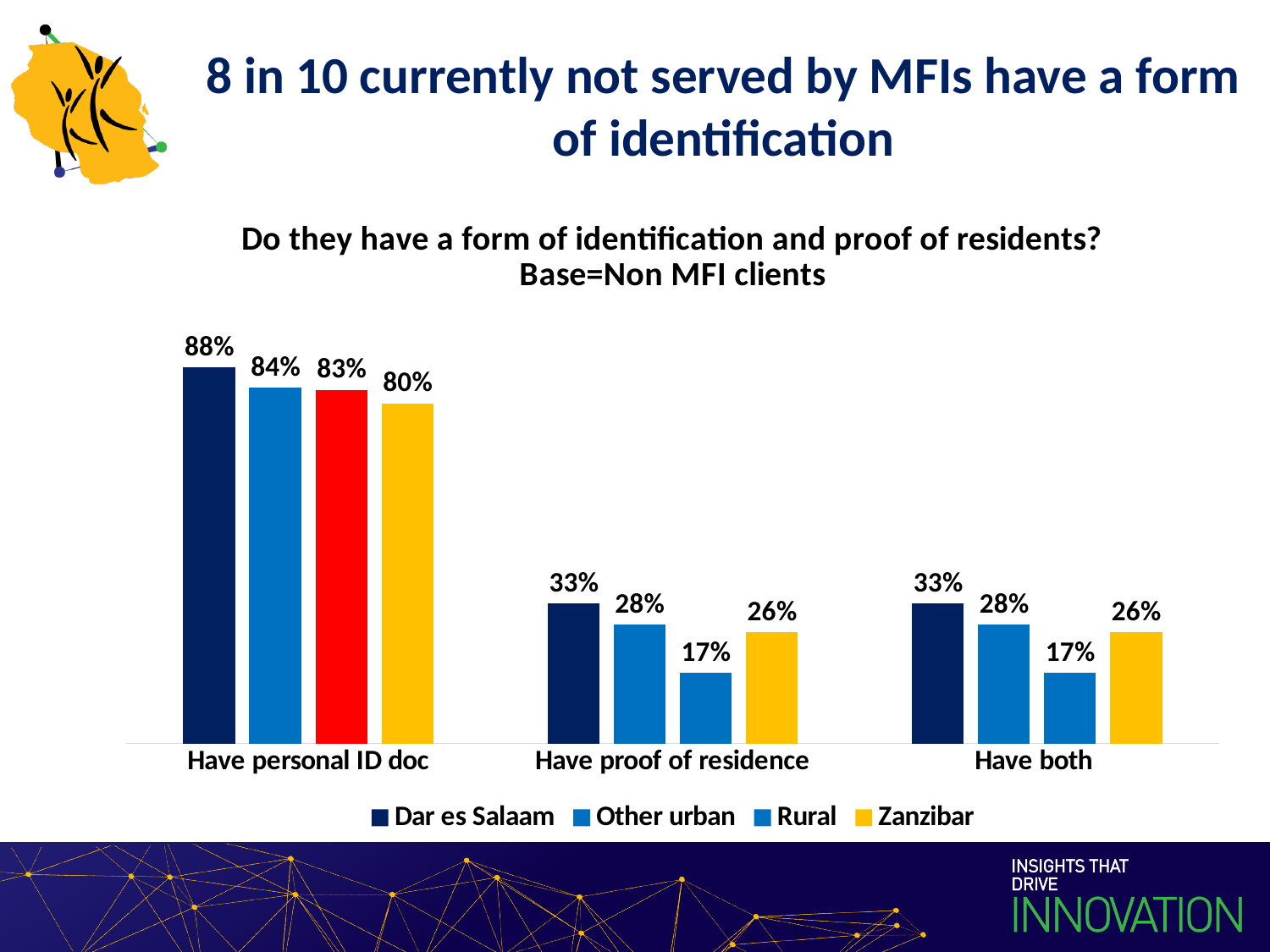
What is the value for Dar es Salaam in the 'Have personal ID doc' category? 88% Which region has the highest value in the 'Have proof of residence' category? Dar es Salaam What is the value for Other urban in the 'Have both' category? 28% What is the value for Rural in the 'Have proof of residence' category? 17% How many series does the legend list? 4 Which is larger: the Zanzibar value or the Rural value in the 'Have both' category? Zanzibar Which region has the lowest value in the 'Have both' category? Rural What kind of chart is shown on the slide? Bar chart How many categories are shown on the x axis of the chart? 3 What is the difference between the Other urban and Rural values in the 'Have proof of residence' category? 11% What is the difference between the Dar es Salaam and Zanzibar values in the 'Have personal ID doc' category? 8% What is the value for Zanzibar in the 'Have personal ID doc' category? 80%